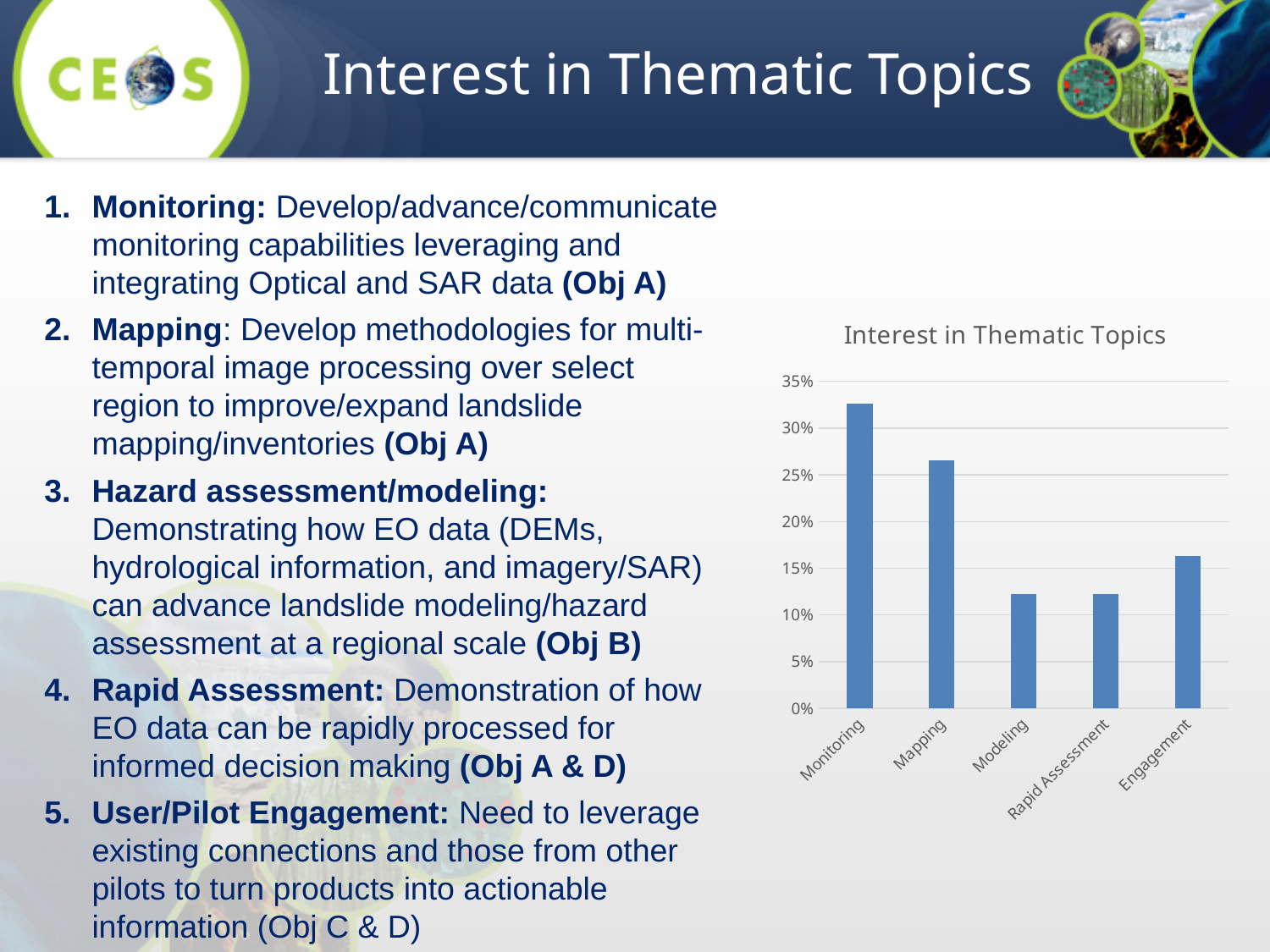
Which is larger, the value for Monitoring or the value for Mapping? Monitoring Is the value for Rapid Assessment greater or less than 10%? greater Which is larger, the value for Engagement or the value for Mapping? Mapping Is the value for Monitoring greater or less than 30%? greater Is the value for Mapping greater or less than 25%? greater What is the title of the chart? Interest in Thematic Topics How many categories are plotted in the chart? 5 Which is larger, the value for Engagement or the value for Modeling? Engagement Which category has the highest value in the chart? Monitoring What kind of chart is shown on the slide? bar chart